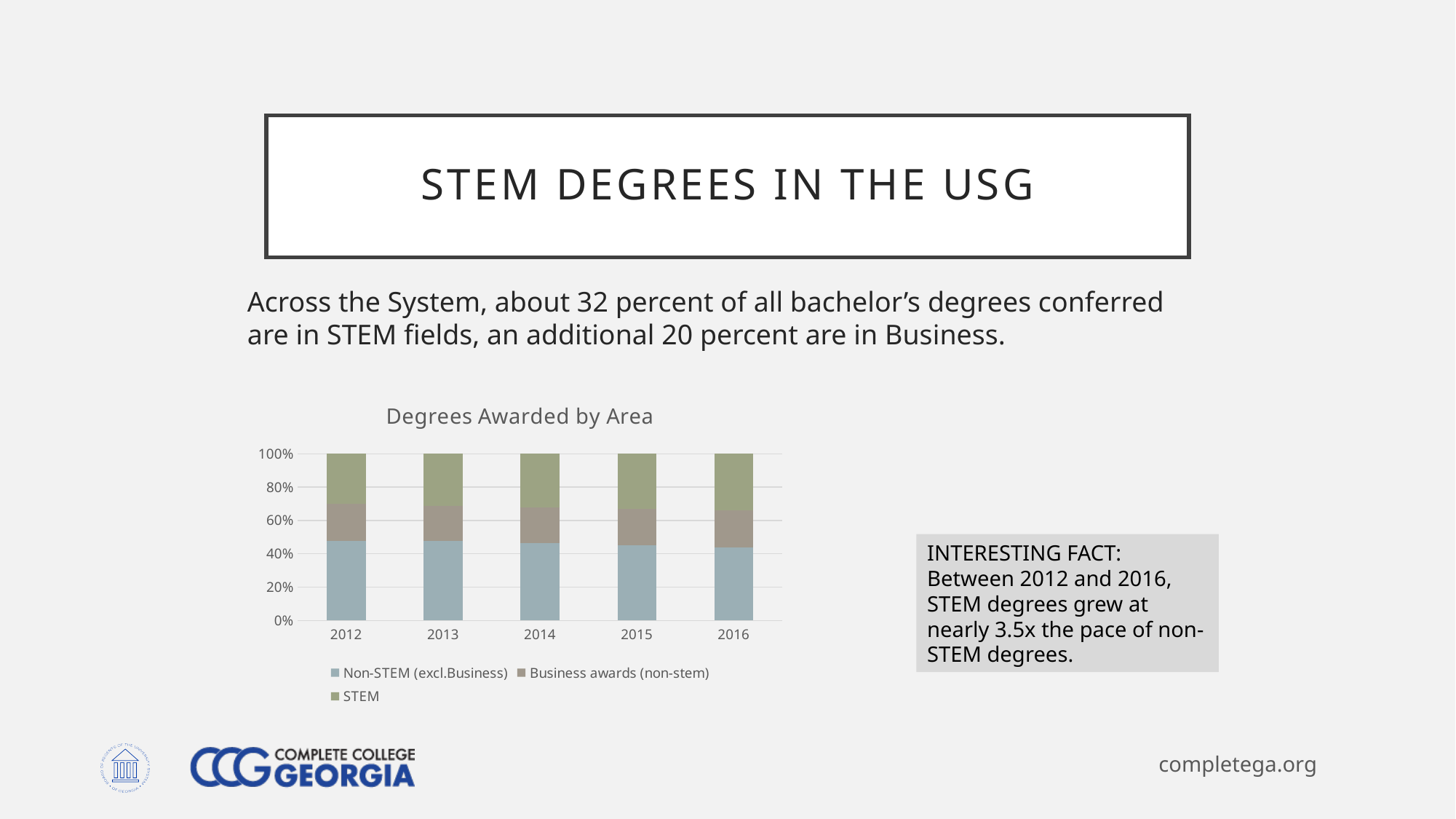
How many series does the chart's legend list? 3 What is the total of each stacked bar in the chart? 100% Is the Non-STEM (excl.Business) share in 2012 greater or less than 60%? less In 2012, which is larger: the Non-STEM (excl.Business) share or the STEM share? Non-STEM (excl.Business) Is the Non-STEM (excl.Business) share in 2014 greater or less than 40%? greater How many years are shown on the x axis of the chart? 5 What is the title of the chart? Degrees Awarded by Area Is the STEM share in 2016 greater or less than 40%? less Which series is shown at the bottom of each stacked bar? Non-STEM (excl.Business) In 2016, which is larger: the Business awards (non-stem) share or the STEM share? STEM What kind of chart is shown on the slide? Stacked bar chart Does the Non-STEM (excl.Business) share rise or fall from 2012 to 2016? fall